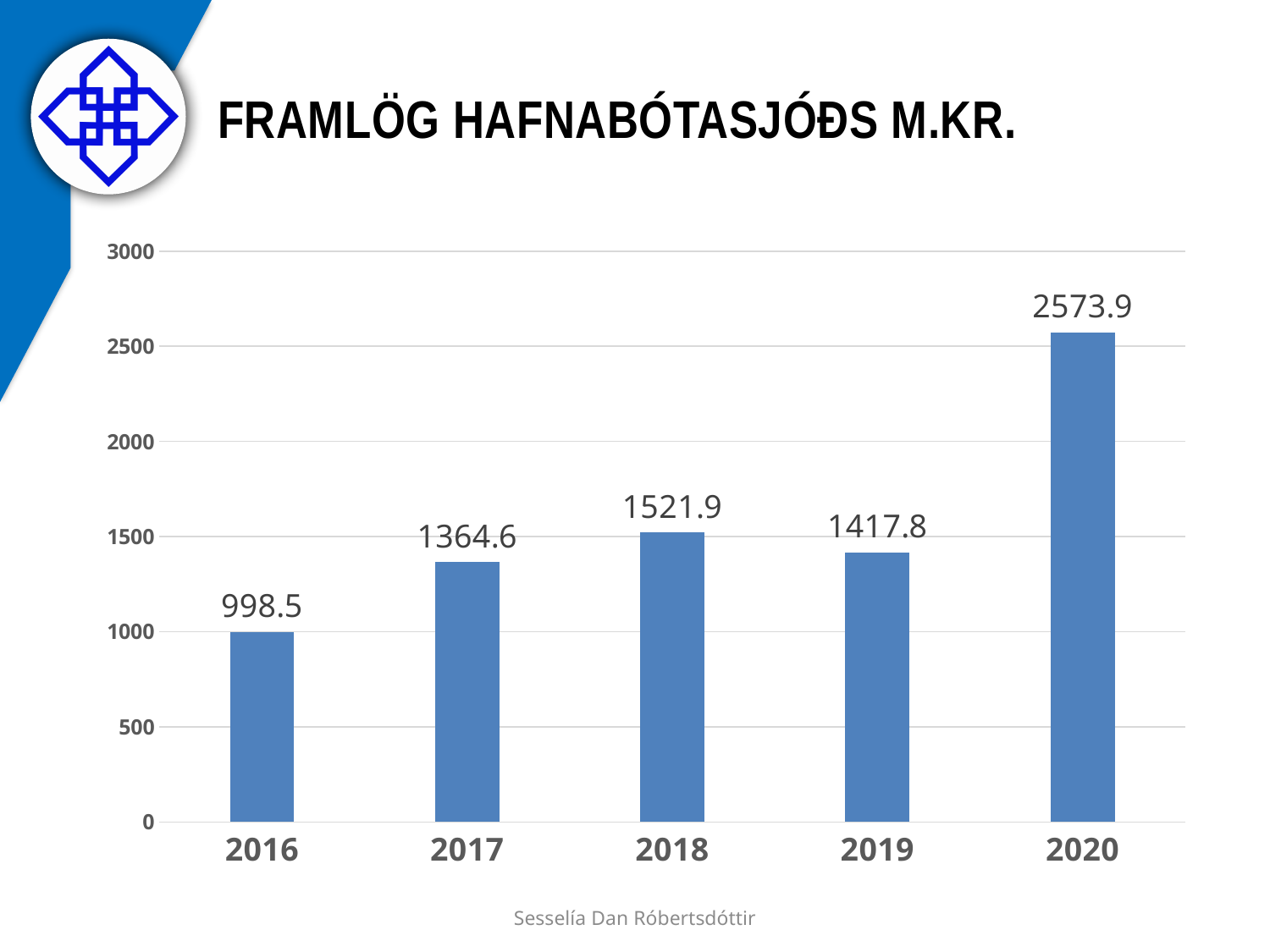
What is the difference between the values for 2018 and 2017? 157.3 How many years are shown on the x axis? 5 Which year has the highest value? 2020 Which year has the lowest value? 2016 Is the value for 2017 greater or less than 1500? less What is the title of the slide? FRAMLÖG HAFNABÓTASJÓÐS M.KR. What is the value for 2016? 998.5 What is the value for 2020? 2573.9 What kind of chart is shown on the slide? bar chart What is the difference between the values for 2020 and 2019? 1156.1 What is the value for 2019? 1417.8 Which is larger, the value for 2018 or the value for 2019? 2018